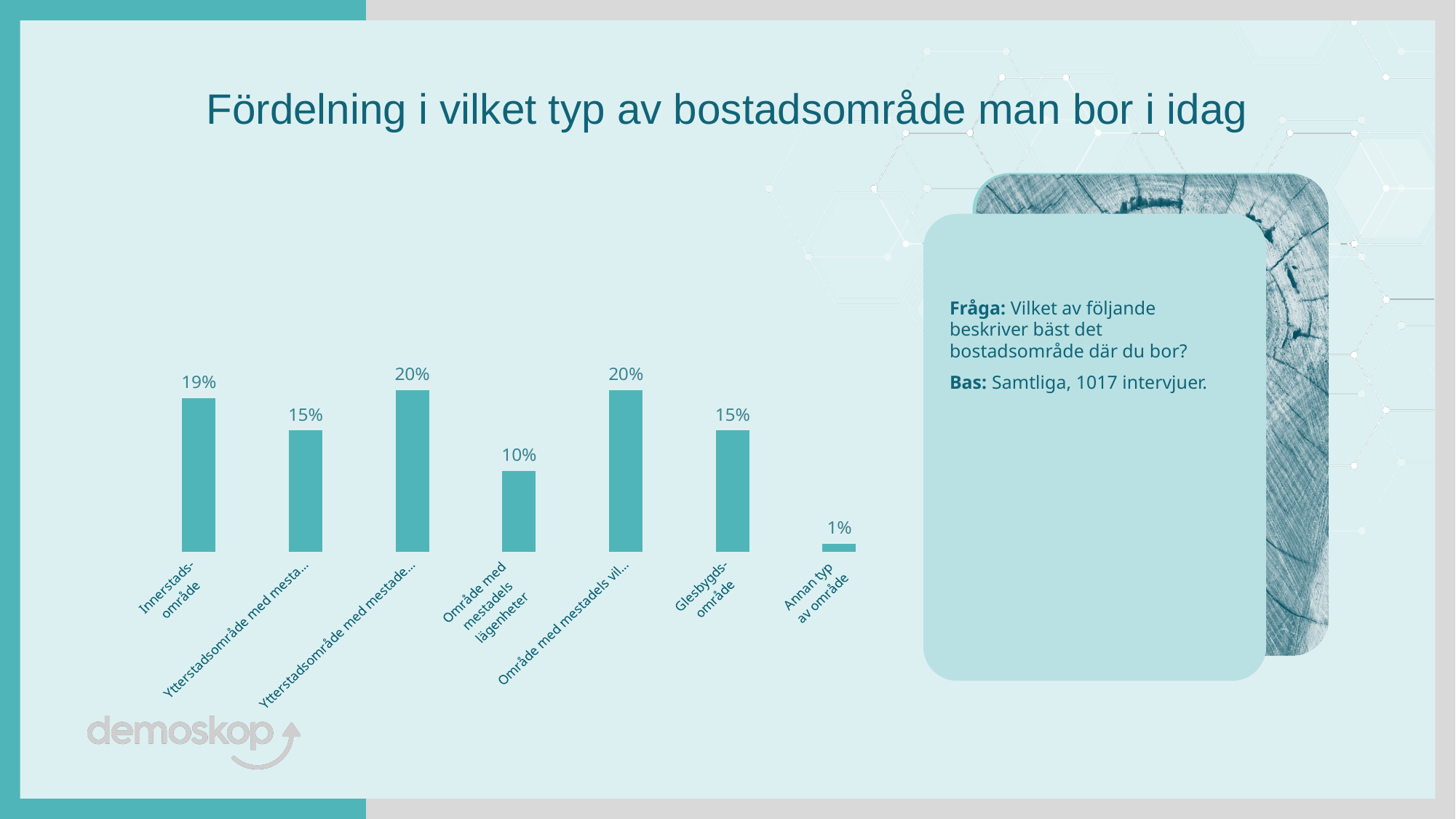
What is the value for Område med mestadels lägenheter? 10% Which is larger, the value for Innerstadsområde or the value for Glesbygdsområde? Innerstadsområde What is the value for Annan typ av område? 1% What is the value for Glesbygdsområde? 15% What is the difference between the value for Innerstadsområde and the value for Område med mestadels lägenheter? 9 percentage points What is the value for Innerstadsområde? 19% How many categories (bars) does the chart show? 7 What is the highest value shown in the chart? 20% What kind of chart is shown on the slide? bar chart Which category has the lowest value? Annan typ av område According to the text box on the slide, how many interviews form the base for the chart? 1017 What is the title of the chart on the slide? Fördelning i vilket typ av bostadsområde man bor i idag